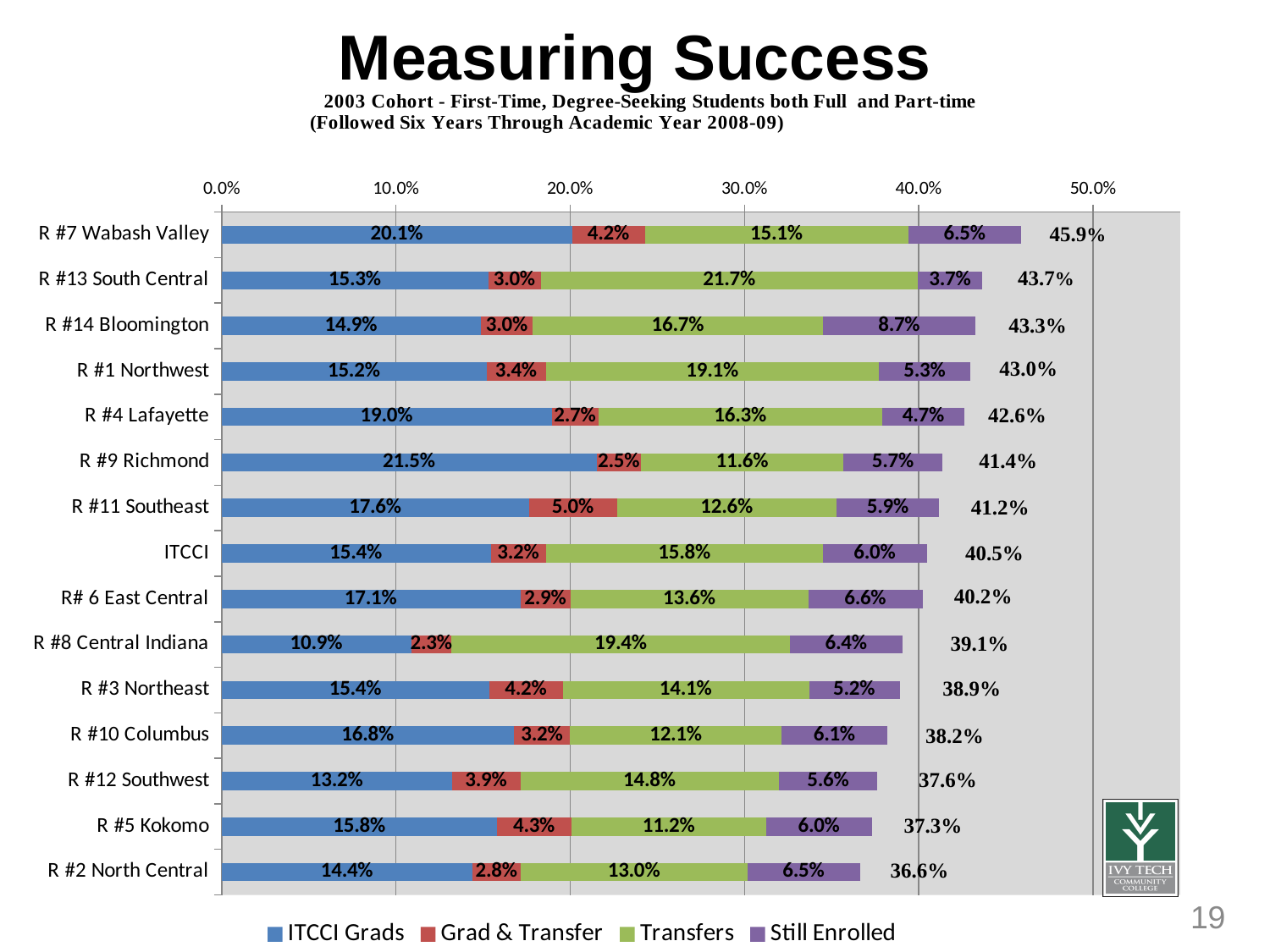
Which region has the highest total bar? R #7 Wabash Valley Which region has the lowest total bar? R #2 North Central How many regions (categories) are shown on the chart? 15 How many series does the legend list? 4 What is the difference between the total for R #7 Wabash Valley and the total for R #2 North Central? 9.3% What is the Still Enrolled value for R #14 Bloomington? 8.7% What is the total of the stacked bar for R #4 Lafayette? 42.6% Which is larger, the Grad & Transfer value for R #11 Southeast or for R #9 Richmond? R #11 Southeast What kind of chart is shown on the slide? Stacked bar chart What is the Transfers value for R #13 South Central? 21.7% Is the total for R #2 North Central greater or less than 40.0%? less What is the ITCCI Grads value for R #7 Wabash Valley? 20.1%